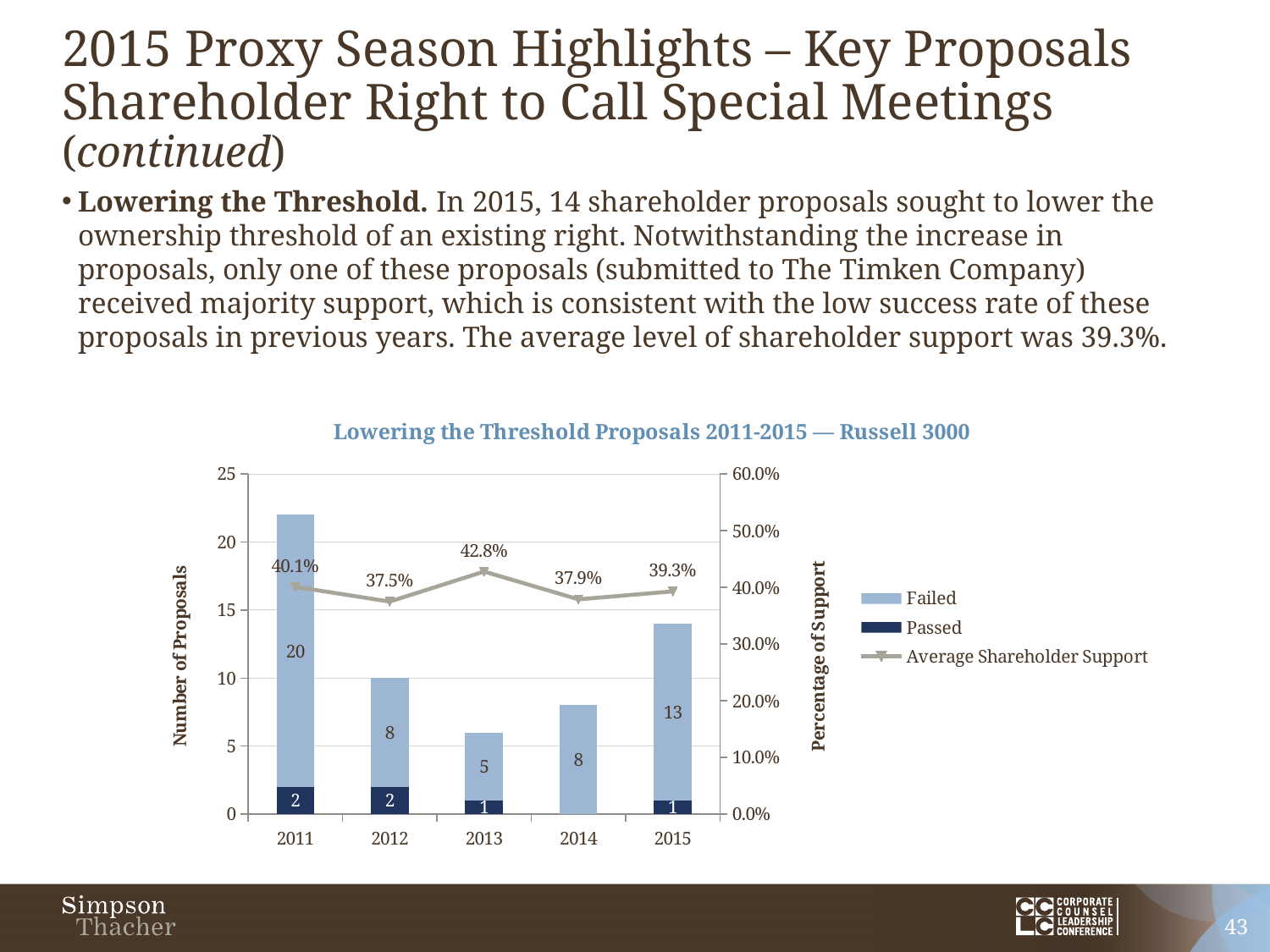
Which is larger, the Average Shareholder Support for 2012 or for 2014? 2014 How many years are shown on the x axis? 5 What is the title of the chart? Lowering the Threshold Proposals 2011-2015 — Russell 3000 What is the Failed value for 2011? 20 What is the total number of proposals (Failed plus Passed) for 2011? 22 Which year has the highest Average Shareholder Support? 2013 Which year has the lowest Failed value? 2013 What is the Passed value for 2015? 1 What is the Average Shareholder Support value for 2013? 42.8% What is the difference between the Failed values for 2011 and 2015? 7 What kind of chart is this? Stacked bar chart with a line How many series does the legend list? 3